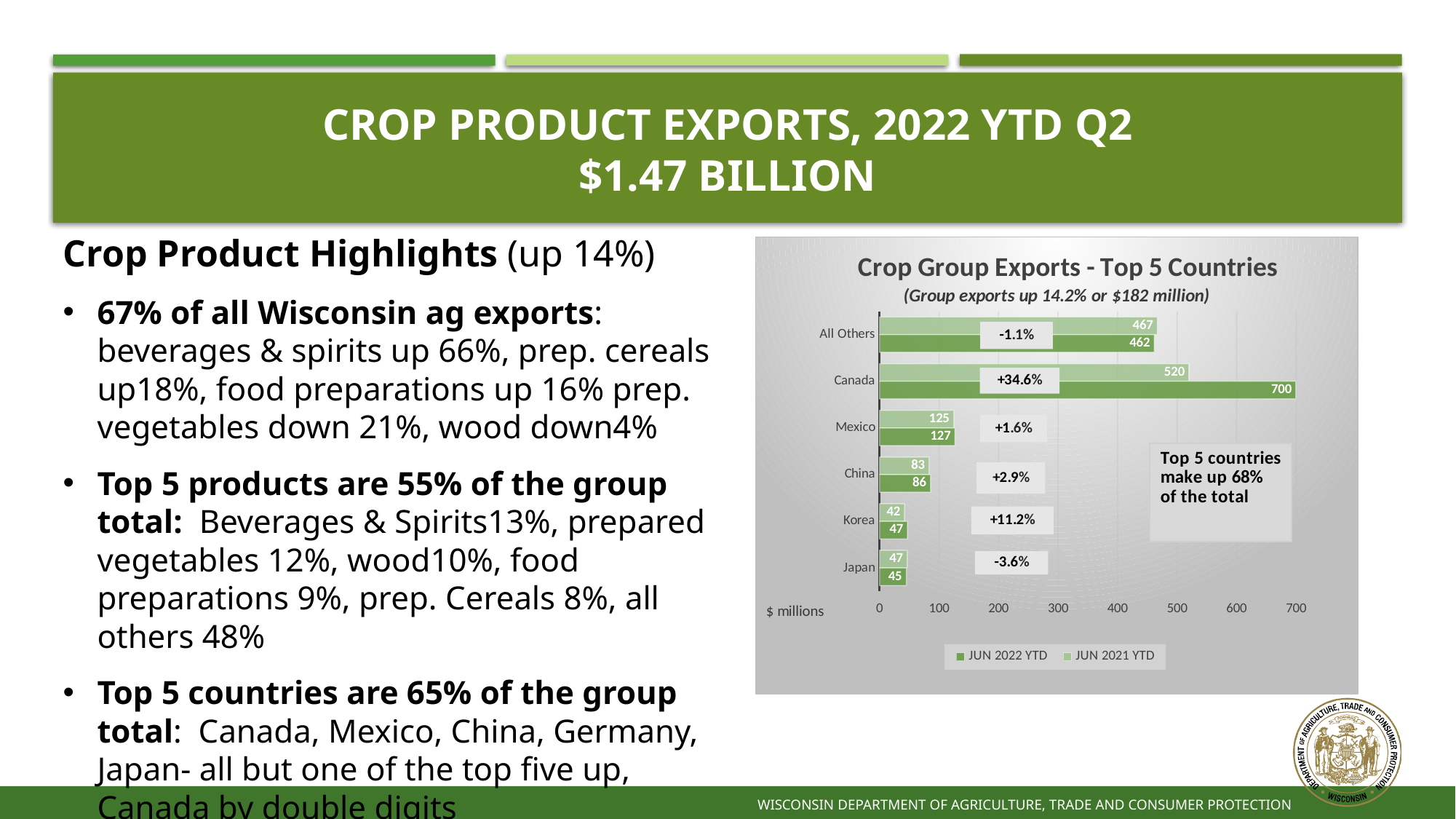
What is the JUN 2021 YTD value for Mexico? 125 What is the difference between Canada's JUN 2022 YTD and JUN 2021 YTD values? 180 What is the JUN 2022 YTD value for Canada? 700 Which is larger for China: the JUN 2022 YTD value or the JUN 2021 YTD value? JUN 2022 YTD What is the JUN 2021 YTD value for All Others? 467 What is the JUN 2022 YTD value for Korea? 47 How many series does the legend list? 2 What type of chart is shown? Bar chart Which country among the named countries has the highest JUN 2022 YTD value? Canada Which category has the lowest JUN 2022 YTD value? Japan How many categories are shown on the chart? 6 Is the JUN 2022 YTD value for Mexico greater or less than 200? less